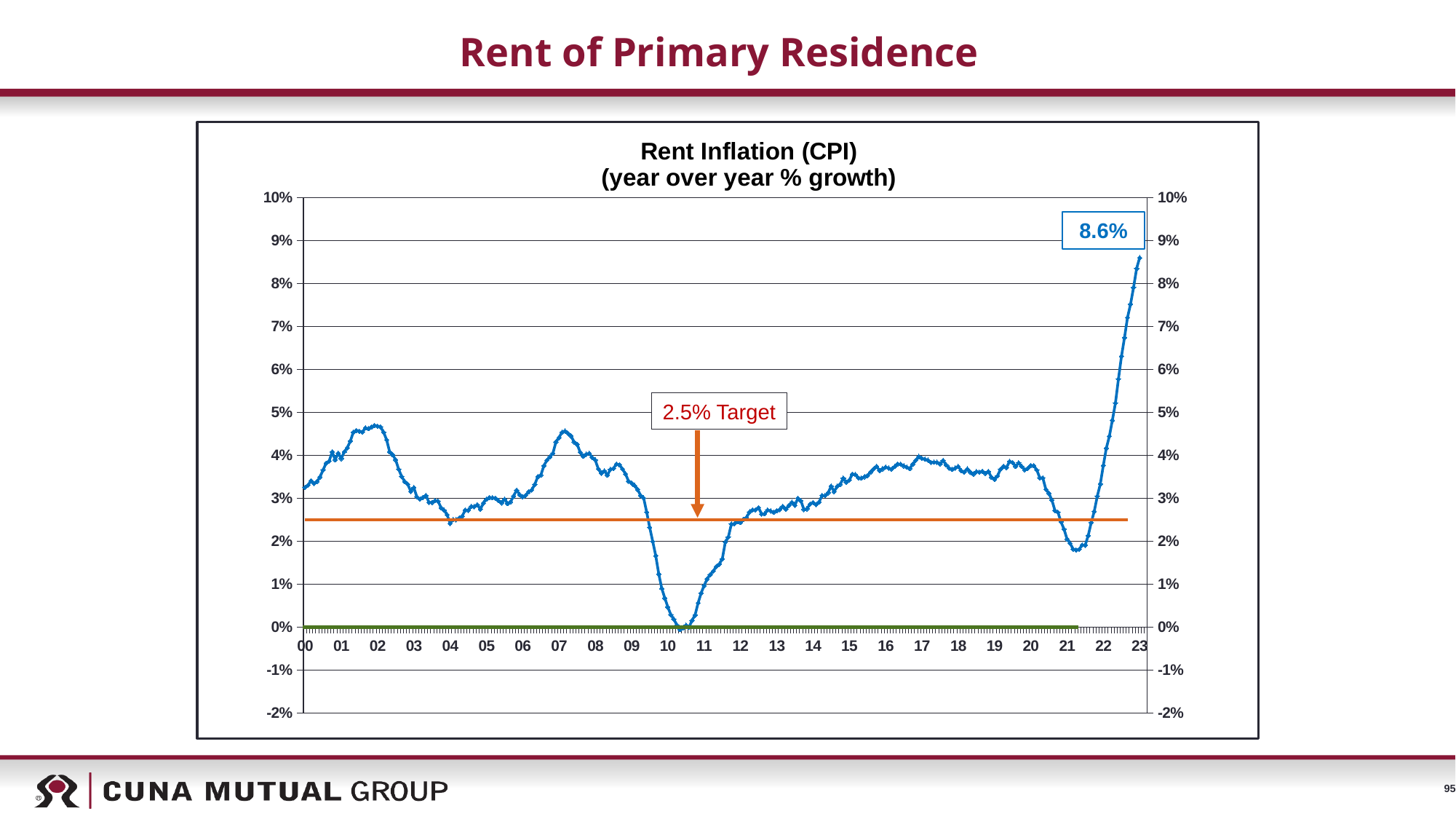
Is the value at 23 greater or less than 8%? greater What is the latest value labeled on the line, at the 23 end of the chart? 8.6% Does the line rise or fall between 21 and 23? rise What target level is marked by the horizontal orange line? 2.5% Target Is the lowest point of the line greater or less than 1%? less Between which two year labels does the line reach its lowest point? 10 and 11 How many year labels are shown on the x axis? 24 In which year label does the line reach its highest value? 23 What kind of chart is shown on the slide? line chart What is the title of the chart? Rent Inflation (CPI) (year over year % growth) Which is larger, the value at 02 or the value at 04? 02 Is the value at 02 greater or less than 4%? greater